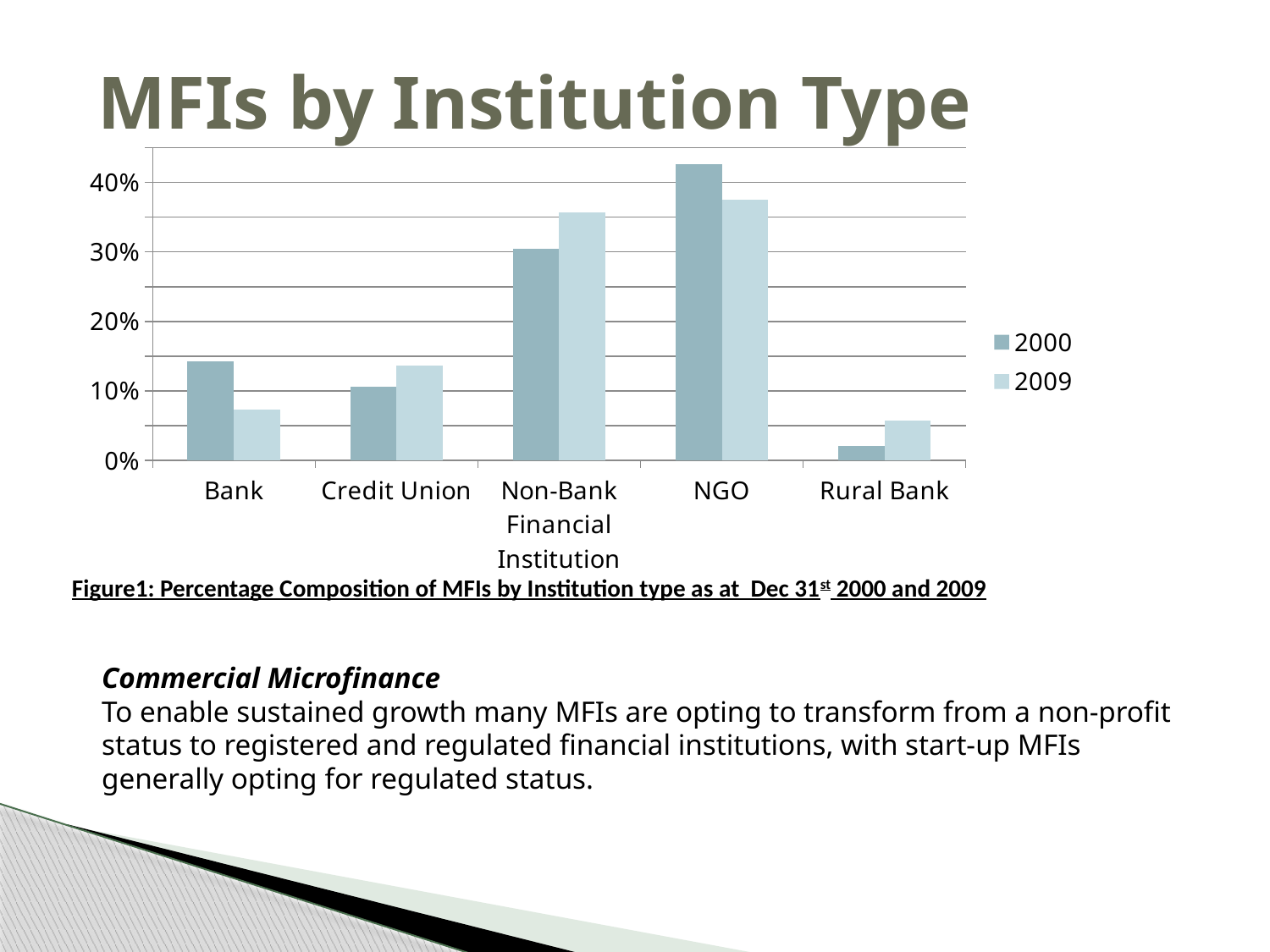
Is the value for Rural Bank in 2009 greater or less than 10%? less What are the two series named in the legend? 2000 and 2009 Which institution type has the highest value for 2009? NGO How many institution type categories are shown on the x axis? 5 How many series does the legend list? 2 Which institution type has the lowest value for 2000? Rural Bank What kind of chart is shown on the slide? bar chart Which institution type has the lowest value for 2009? Rural Bank Is the value for NGO in 2000 greater or less than 40%? greater Which institution type has the highest value for 2000? NGO For Non-Bank Financial Institution, which year has the larger value, 2000 or 2009? 2009 For Bank, which year has the larger value, 2000 or 2009? 2000